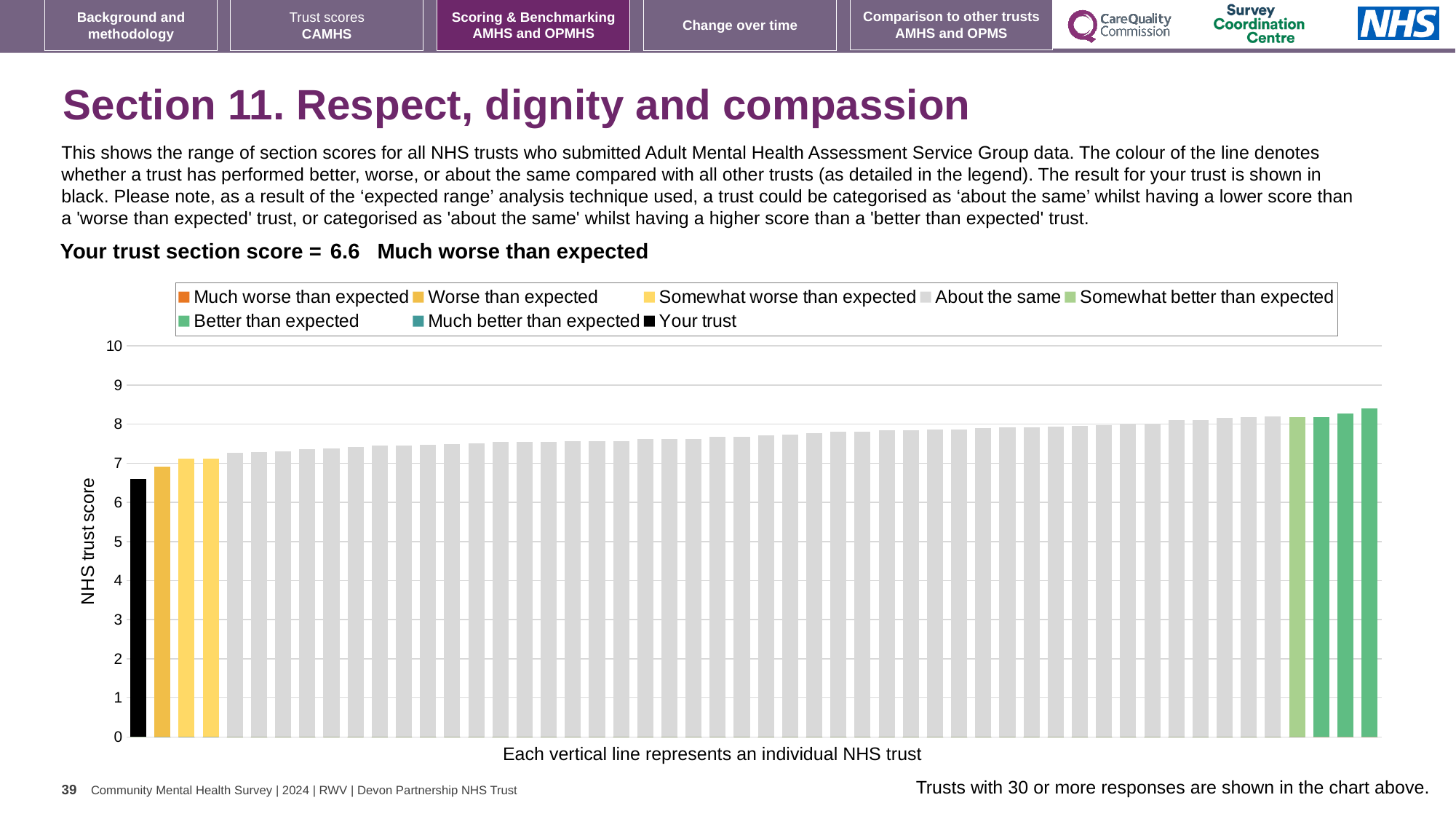
What is the label on the vertical axis of the chart? NHS trust score Is the value of the tallest bar in the chart greater or less than 8? greater Which category does your trust's section score fall into, according to the slide? Much worse than expected What is the section score for your trust shown on the slide? 6.6 Is the black 'Your trust' bar taller or shorter than the yellow bar immediately to its right? shorter Is the value of the black 'Your trust' bar greater or less than 7? less Which legend category does the tallest bar in the chart belong to? Better than expected What kind of chart is shown on the slide? bar chart What does each vertical line in the chart represent, according to the x-axis label? an individual NHS trust Which legend category does the lowest bar in the chart belong to? Your trust Do the bar values rise or fall moving from left to right along the x axis? rise How many entries does the chart legend list? 8